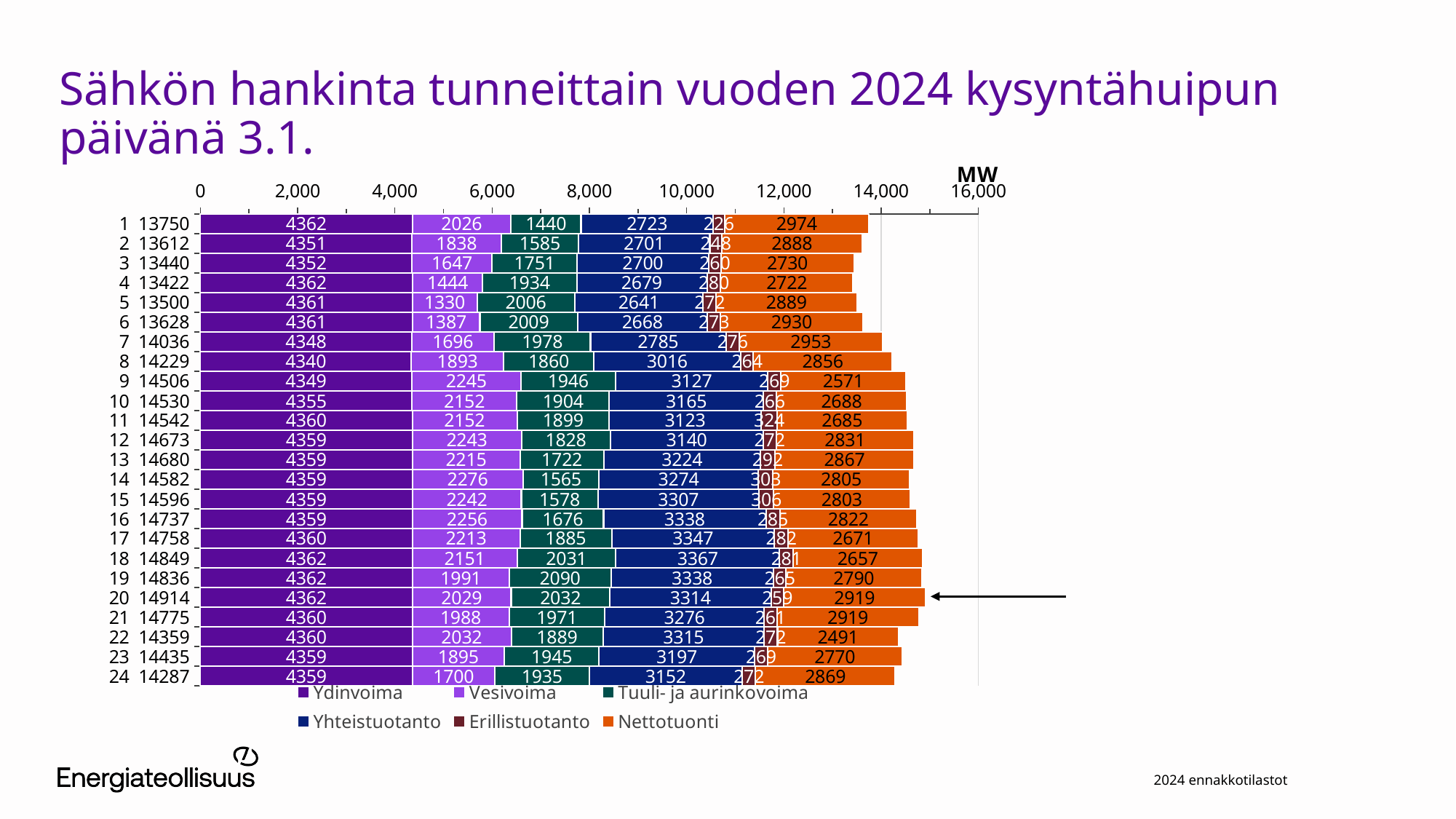
What is the difference between the Nettotuonti value for hour 1 and for hour 22? 483 What is the Ydinvoima value for hour 1? 4362 How many series does the legend list? 6 Which hour has the highest total electricity supply? 20 What kind of chart is shown on the slide? stacked bar chart How many hours (bars) are shown in the chart? 24 What is the total of the stacked bar for hour 20? 14914 What is the Nettotuonti value for hour 20? 2919 What is the Yhteistuotanto value for hour 18? 3367 Which is larger, the Tuuli- ja aurinkovoima value for hour 19 or for hour 1? hour 19 Is the total for hour 1 greater or less than 14,000? less Which hour has the lowest total electricity supply? 4